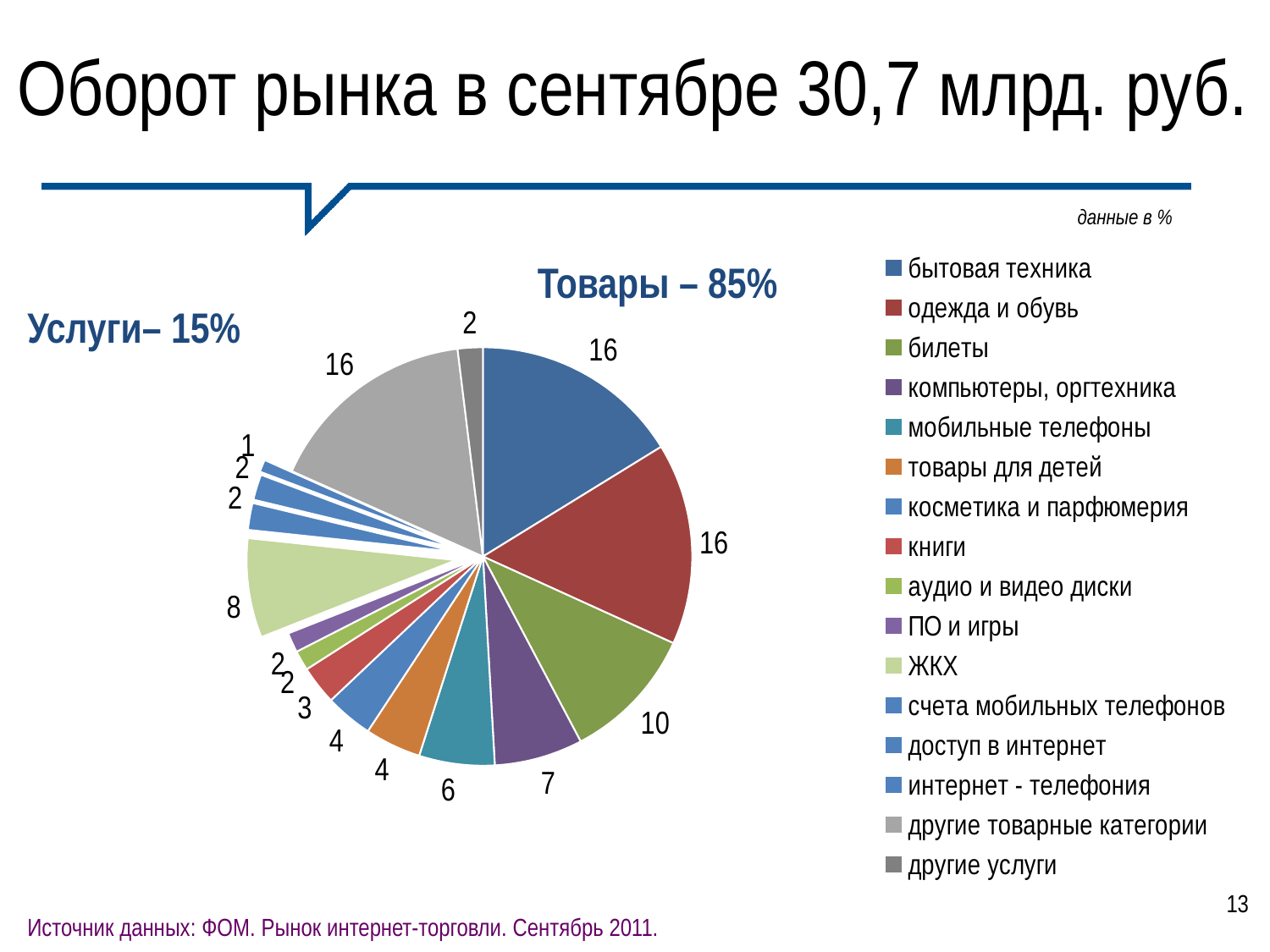
Which category has the smallest slice in the pie chart? интернет - телефония According to the slide, what share of the market do Товары (goods) account for? 85% What is the value for компьютеры, оргтехника? 7 What is the value for мобильные телефоны? 6 What kind of chart is shown on the slide? pie chart What is the value for книги? 3 What is the difference between the values for билеты and мобильные телефоны? 4 How many categories does the legend list? 16 What share of the pie does бытовая техника represent? 16% What is the value for ЖКХ? 8 What is the value for билеты? 10 Which is larger, the value for ЖКХ or the value for компьютеры, оргтехника? ЖКХ